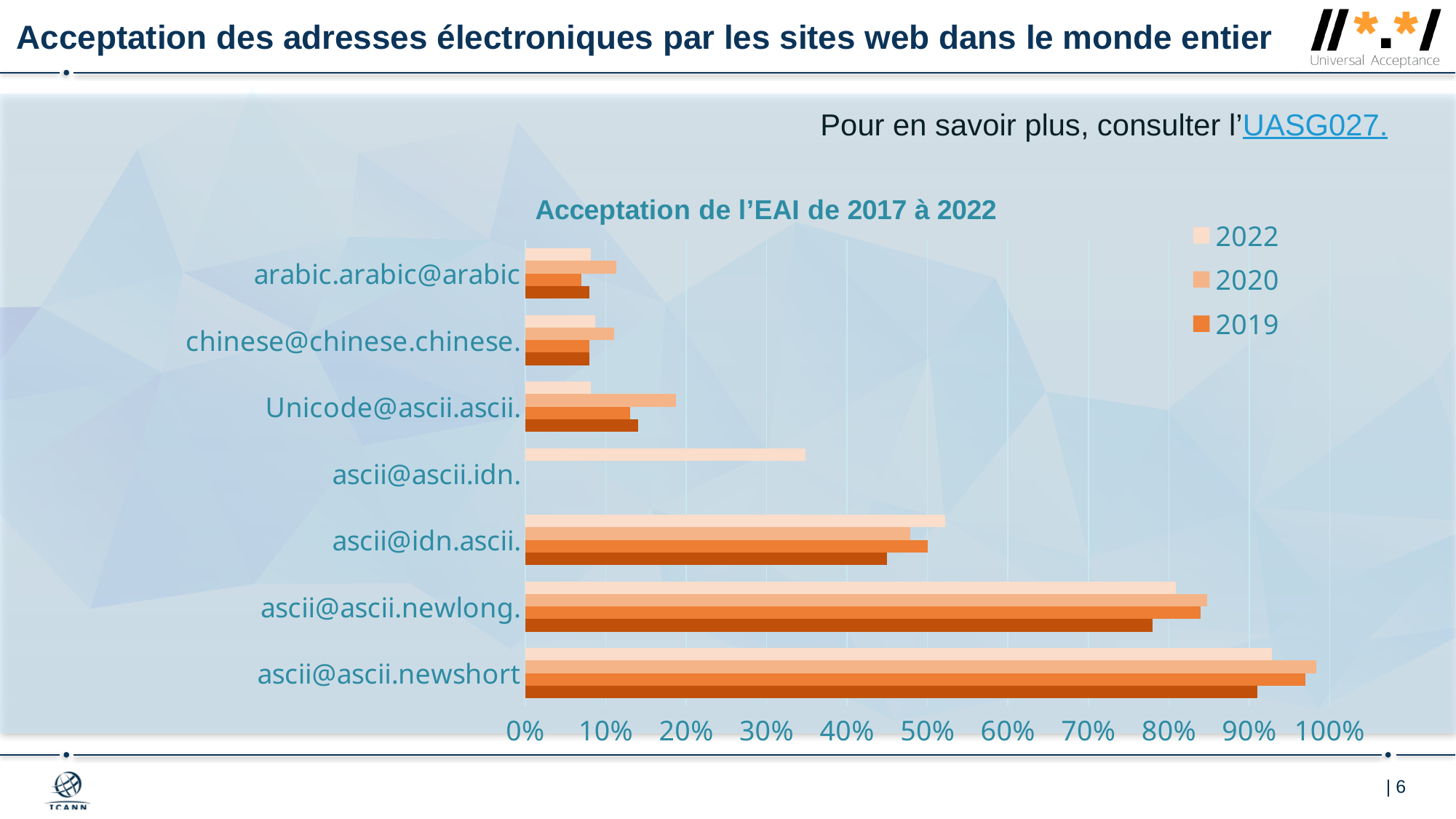
Which category has the highest value for 2019? ascii@ascii.newshort For Unicode@ascii.ascii., which is larger: the 2020 value or the 2022 value? 2020 Which category has the highest value for 2022? ascii@ascii.newshort How many categories (email address formats) are listed on the chart? 7 What kind of chart is shown on the slide? Bar chart Which years are listed in the chart legend? 2022, 2020, 2019 How many series does the chart legend list? 3 Is the 2019 value for ascii@ascii.newshort greater or less than 80%? greater What is the title of the chart? Acceptation de l'EAI de 2017 à 2022 Is the 2022 value for ascii@ascii.idn. greater or less than 30%? greater